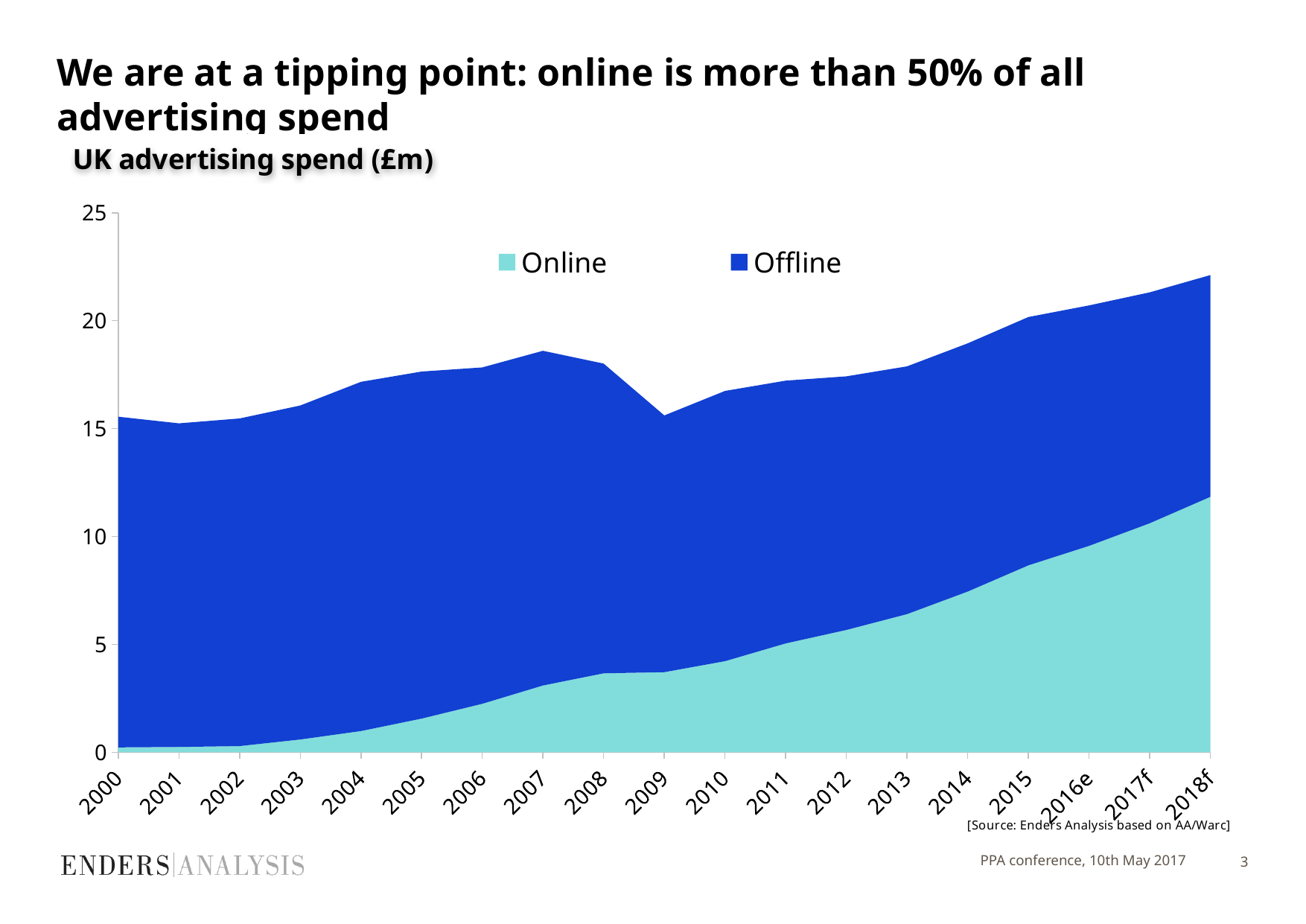
Does the Online series generally rise or fall from 2000 to 2018f? rise In which year is the Online value highest? 2018f What kind of chart is shown on the slide? Stacked area chart What is the title of the chart? UK advertising spend (£m) Is the total advertising spend for 2018f greater or less than 20? greater Is the Online value for 2018f greater or less than 10? greater Is the total advertising spend for 2007 greater or less than 20? less How many series does the legend list? 2 Which two series are shown in the legend? Online and Offline How many years are shown along the x axis? 19